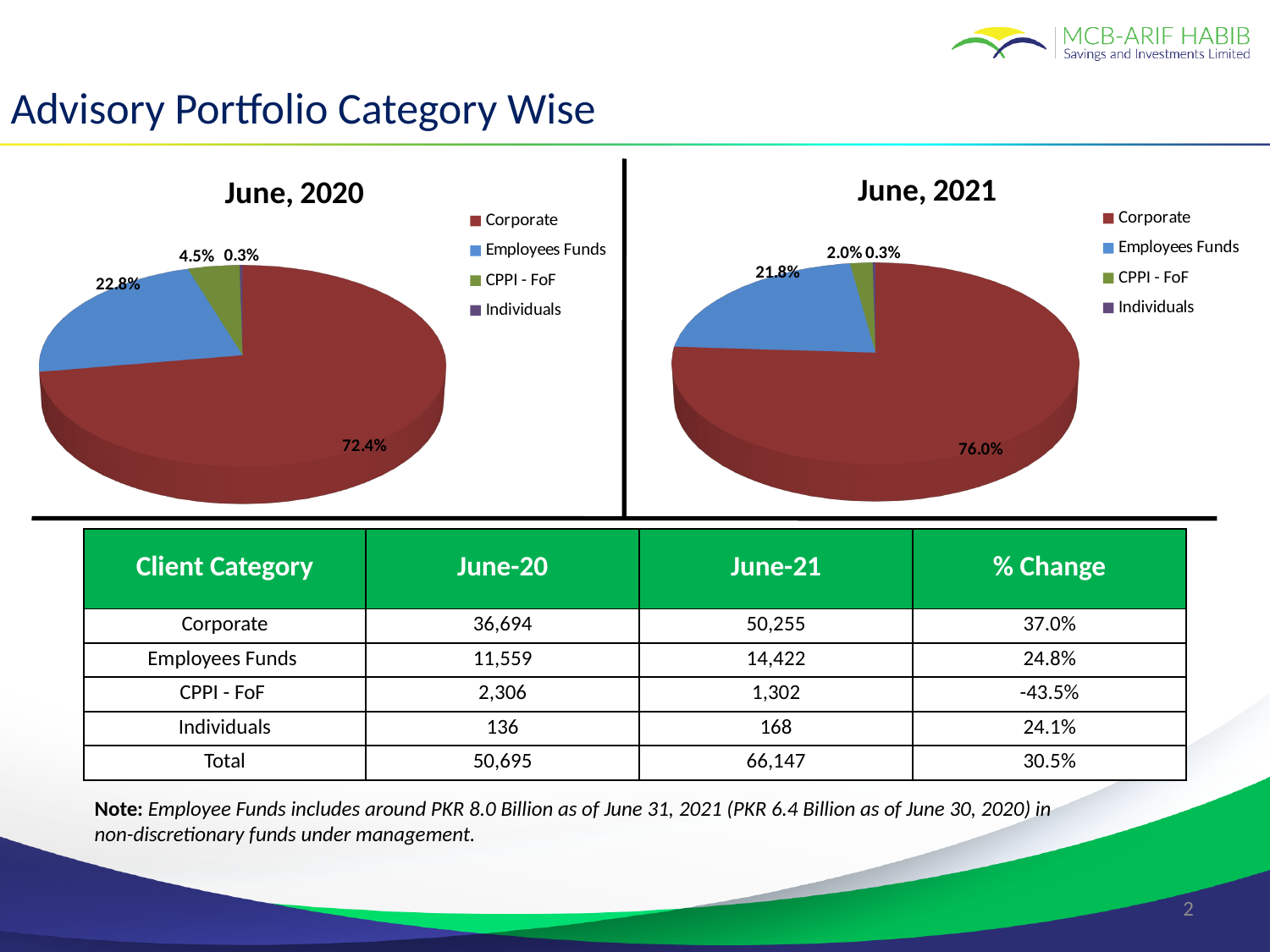
In the June, 2021 pie chart, what is the share for Employees Funds? 21.8% In the June, 2020 pie chart, which category has the largest share? Corporate In the June, 2020 pie chart, what share does Corporate hold? 72.4% Is the CPPI - FoF share larger in the June, 2020 pie chart or the June, 2021 pie chart? June, 2020 What is the difference between the Corporate share in the June, 2021 pie chart and the Corporate share in the June, 2020 pie chart? 3.6% In the June, 2021 pie chart, what is the share for CPPI - FoF? 2.0% In the June, 2021 pie chart, which category has the smallest share? Individuals How many categories does the legend of the June, 2020 pie chart list? 4 In the June, 2021 pie chart, what share does Corporate hold? 76.0% What type of chart is used for June, 2021? Pie chart In the June, 2020 pie chart, what is the share for CPPI - FoF? 4.5% In the June, 2020 pie chart, what is the share for Employees Funds? 22.8%